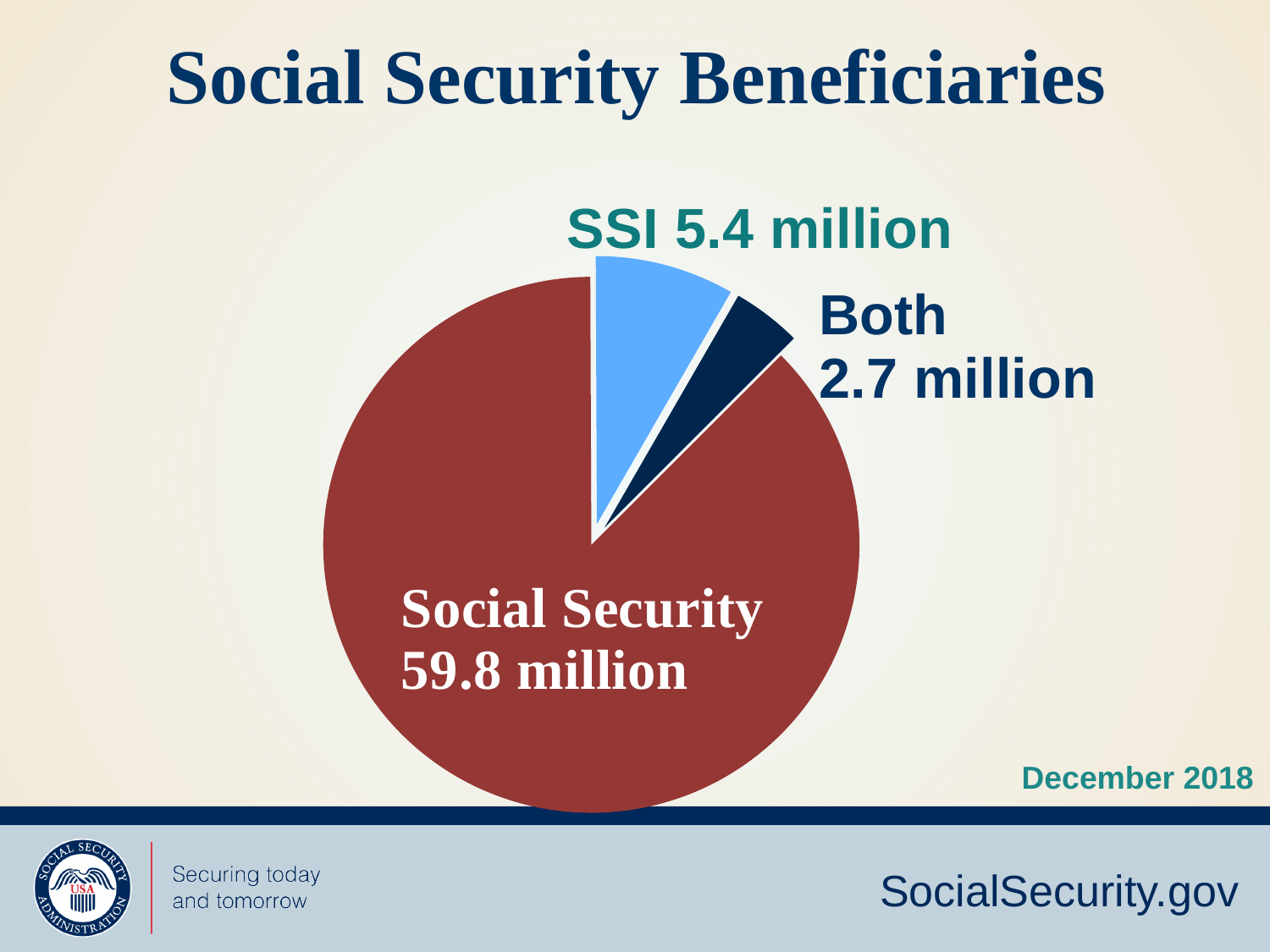
How many beneficiaries receive Both? 2.7 million What kind of chart is shown on the slide? Pie chart Which slice of the pie is the largest? Social Security What is the title of the chart? Social Security Beneficiaries How many beneficiaries are in the Social Security slice? 59.8 million How many slices does the pie chart have? 3 Which is larger, the SSI slice or the Both slice? SSI What is the total of all three slices in the pie chart? 67.9 million What is the difference between the Social Security value and the SSI value? 54.4 million How many beneficiaries are in the SSI slice? 5.4 million What is the difference between the SSI value and the Both value? 2.7 million Which slice of the pie is the smallest? Both